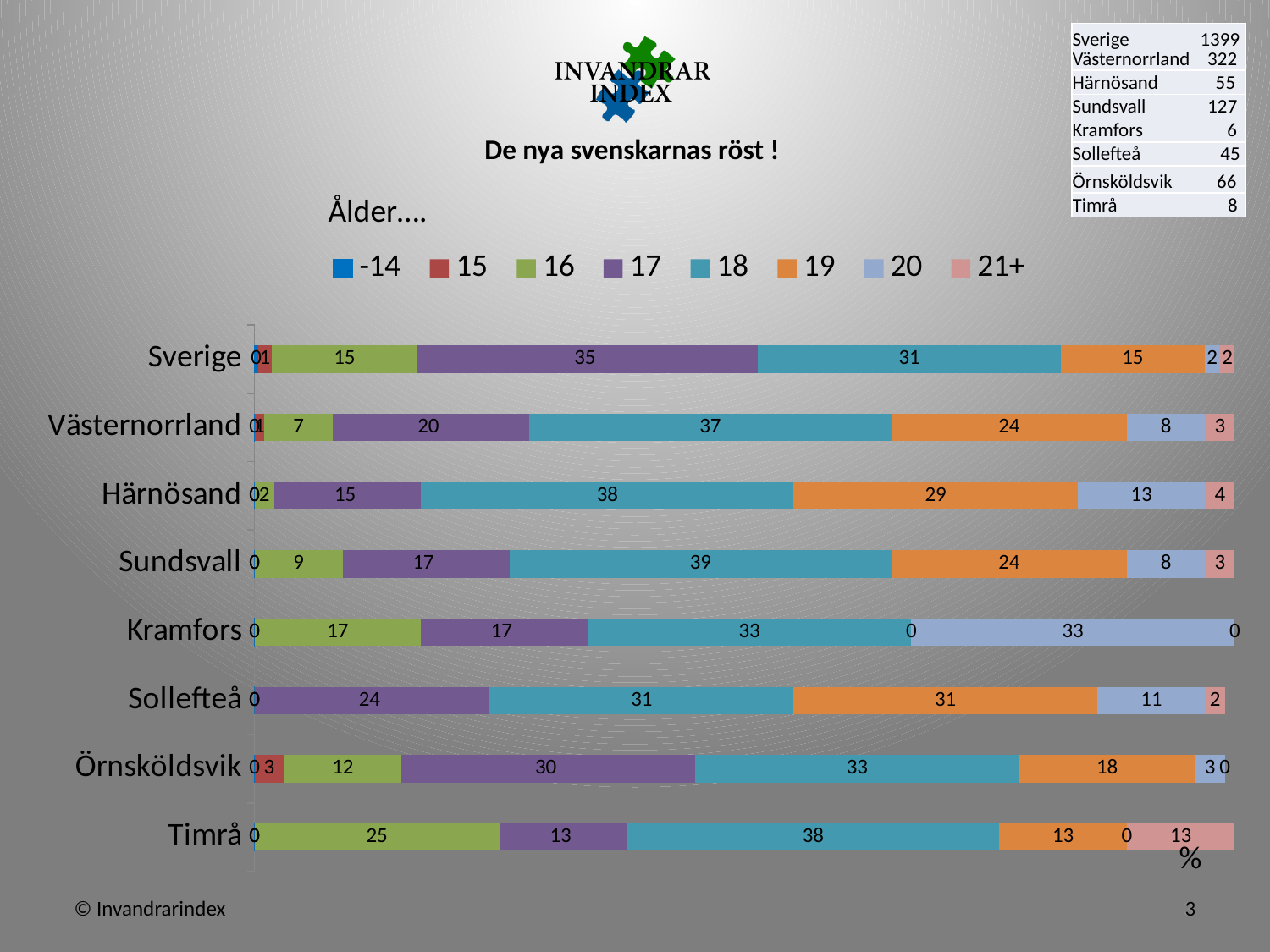
Which is larger, the 19 value for Sollefteå or the 19 value for Örnsköldsvik? Sollefteå What is the value for the 16 age group for Timrå? 25 What is the difference between the 18 value for Västernorrland and the 18 value for Sverige? 6 What is the value for the 18 age group for Sundsvall? 39 Which region has the highest value for the 17 age group? Sverige What is the title of the chart? Ålder…. What is the value for the 17 age group for Sverige? 35 What is the value for the 19 age group for Härnösand? 29 How many regions are shown on the chart? 8 What kind of chart is shown on the slide? stacked bar chart How many age groups does the legend list? 8 Which region has the highest value for the 18 age group? Sundsvall